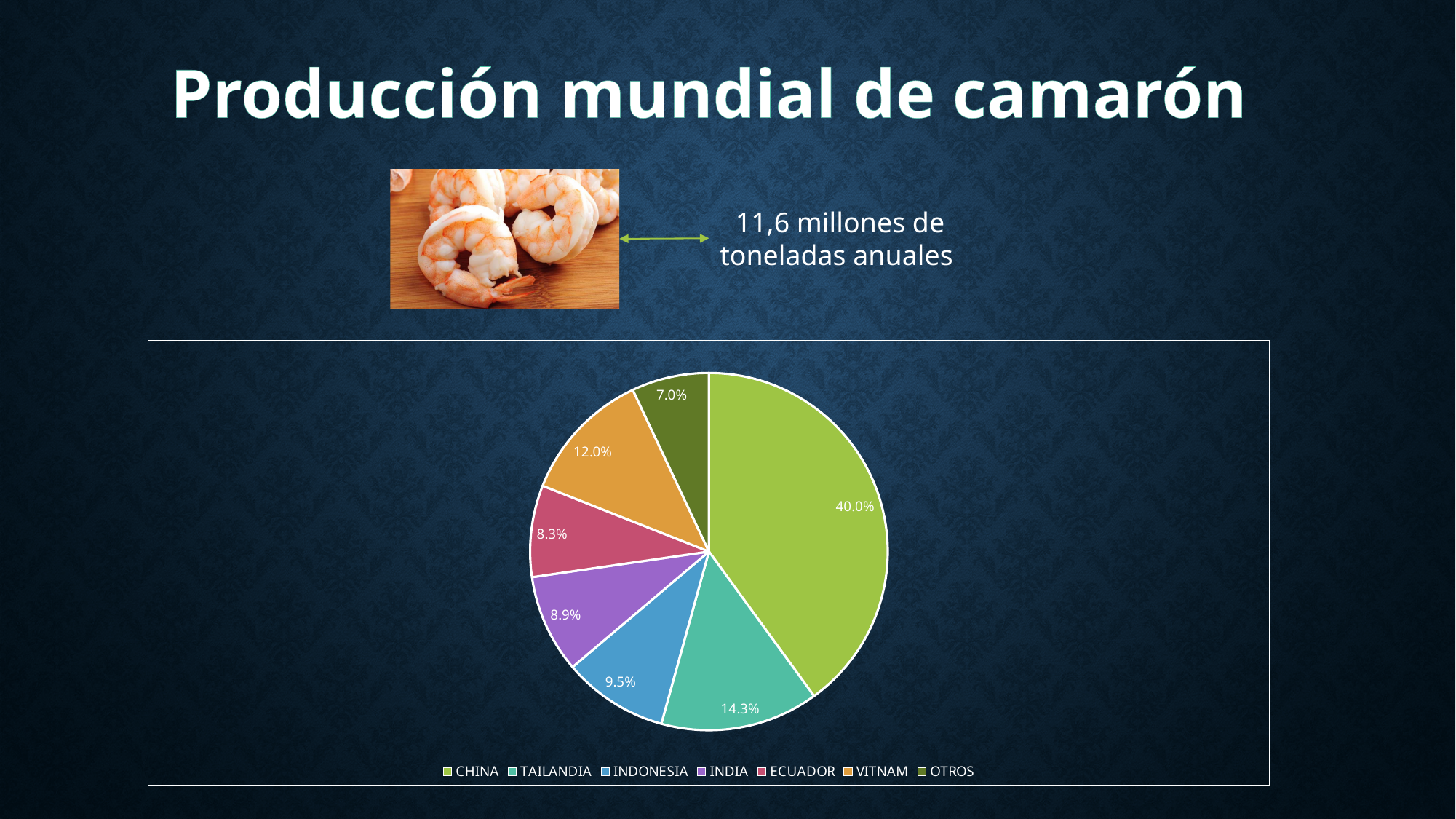
Which category has the largest slice of the pie? CHINA What is the title of the slide containing the pie chart? Producción mundial de camarón What is the difference between the shares of CHINA and TAILANDIA? 25.7% Which has a larger share, INDONESIA or INDIA? INDONESIA How many categories does the pie chart show? 7 Which category has the smallest slice of the pie? OTROS What share of the pie does CHINA have? 40.0% What share of the pie does VITNAM have? 12.0% What share of the pie does ECUADOR have? 8.3% What kind of chart is shown on the slide? pie chart What share of the pie does OTROS have? 7.0% What share of the pie does TAILANDIA have? 14.3%